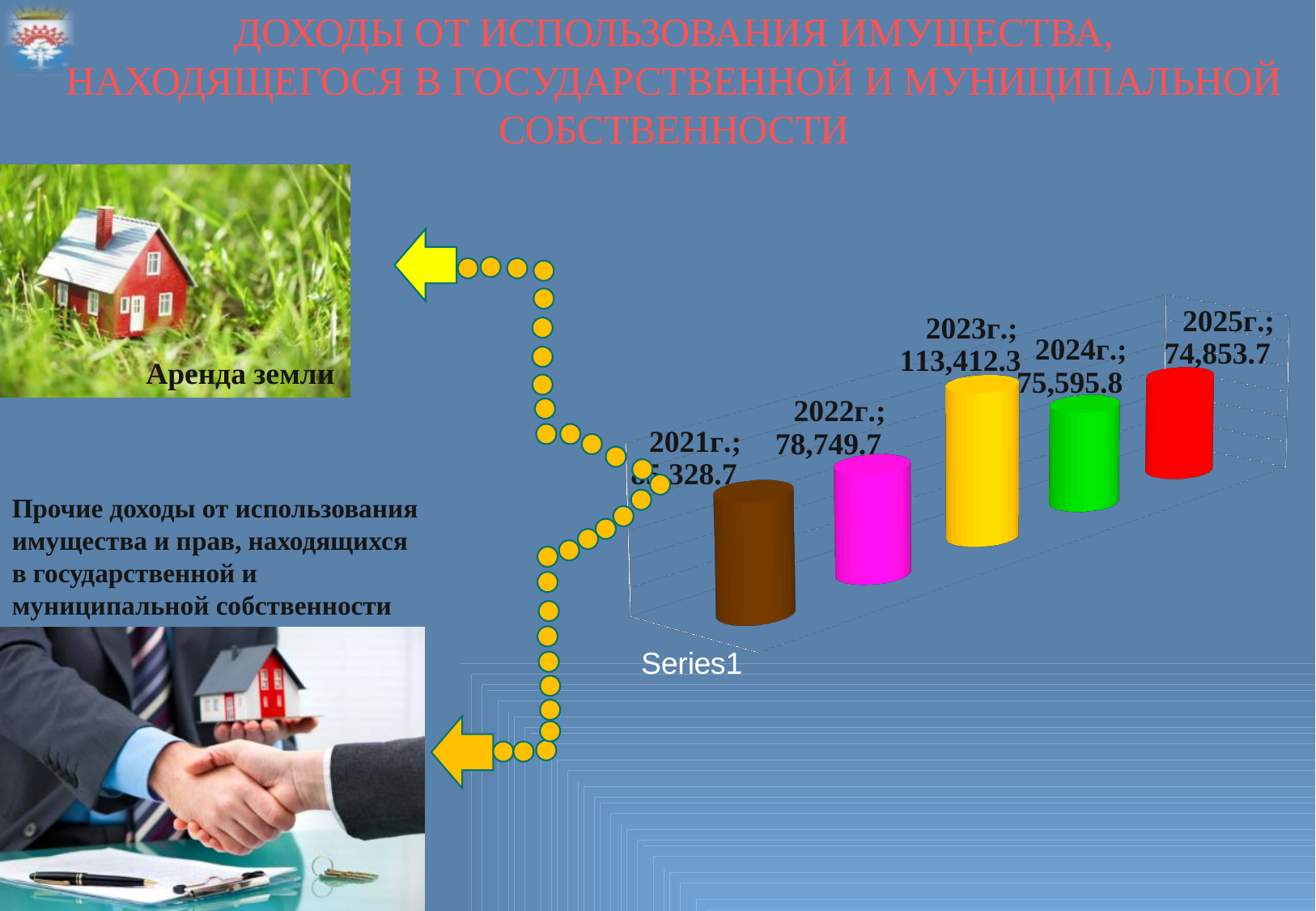
What is the value shown for 2023г. in the chart? 113,412.3 What kind of chart is shown on the slide? Bar chart What is the value shown for 2025г. in the chart? 74,853.7 How many data series does the chart show? 1 How many years (categories) are plotted in the chart? 5 What is the value shown for 2024г. in the chart? 75,595.8 Which is larger, the value for 2022г. or the value for 2024г.? 2022г. What is the value shown for 2022г. in the chart? 78,749.7 Which year has the highest value in the chart? 2023г. What is the difference between the values for 2023г. and 2024г.? 37,816.5 Do the values rise or fall from 2023г. to 2025г.? Fall What is the difference between the values for 2024г. and 2025г.? 742.1